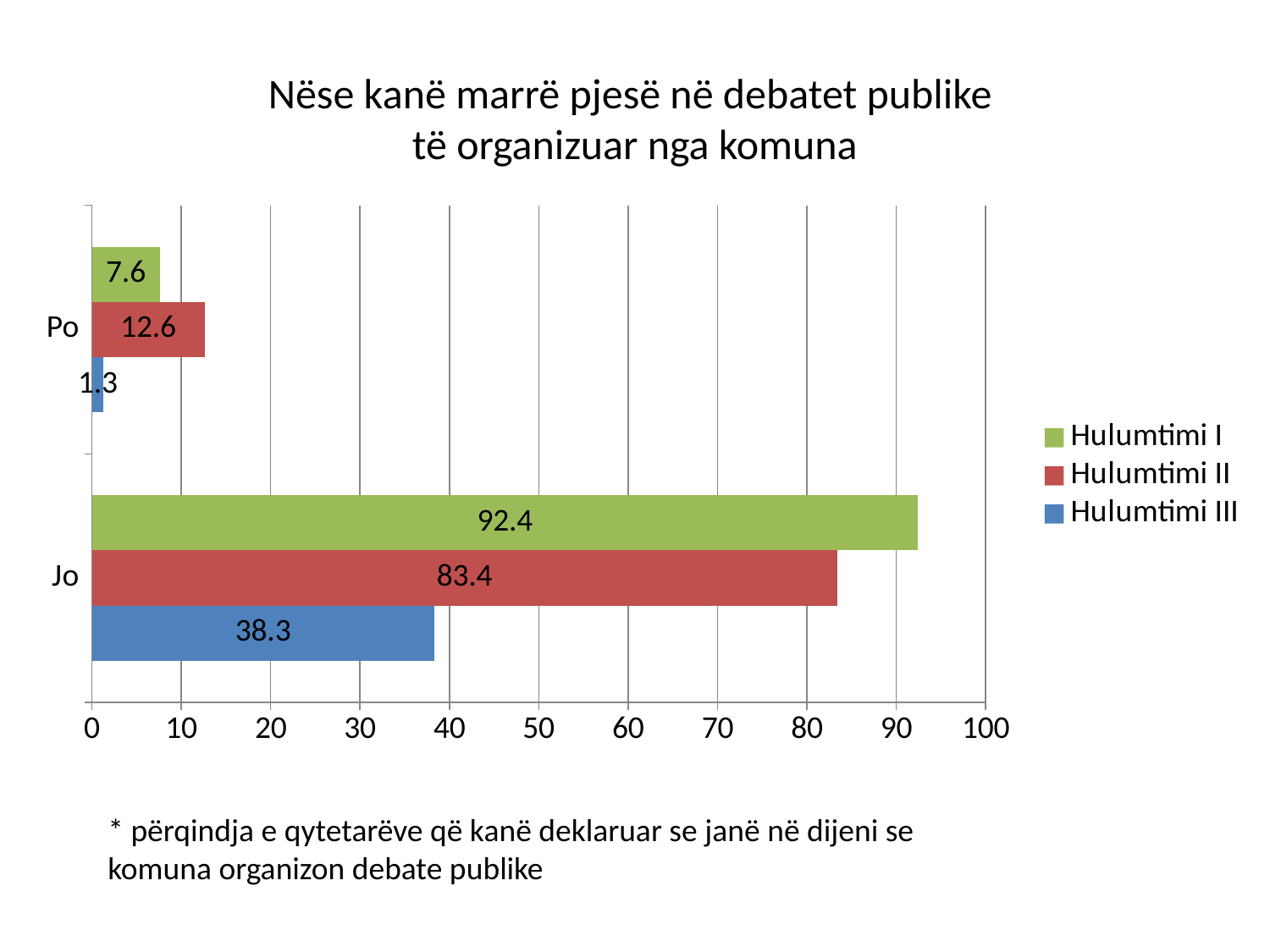
What colour represents Hulumtimi II in the chart? red How many series does the legend list? 3 What kind of chart is shown on the slide? bar chart Which series has the highest value in the Jo category? Hulumtimi I What is the value for Hulumtimi I in the Po category? 7.6 What is the difference between Hulumtimi I and Hulumtimi II in the Jo category? 9 Is the value for Hulumtimi III in the Jo category greater or less than 40? less What is the value for Hulumtimi II in the Jo category? 83.4 What is the value for Hulumtimi III in the Po category? 1.3 What is the value for Hulumtimi III in the Jo category? 38.3 Which series has the lowest value in the Po category? Hulumtimi III Which is larger in the Po category: Hulumtimi I or Hulumtimi II? Hulumtimi II